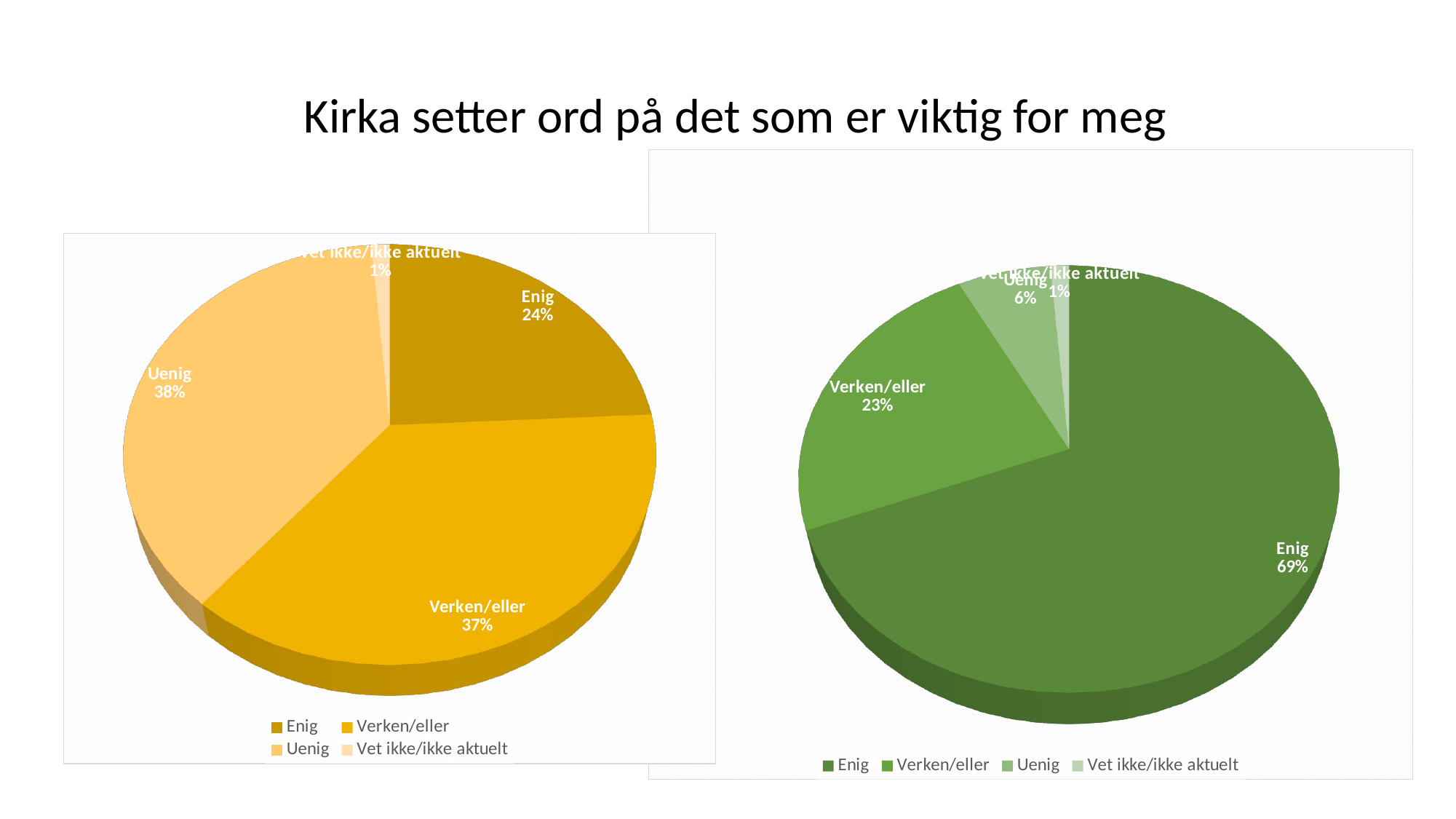
In the right pie chart, what is the share for Enig? 69% What kind of chart is the left chart? Pie chart In the right pie chart, what is the difference in percentage points between Enig and Verken/eller? 46 In the right pie chart, which category has the largest slice? Enig In the left pie chart, what is the share for Enig? 24% In the left pie chart, which category has the smallest slice? Vet ikke/ikke aktuelt In the left pie chart, what is the share for Verken/eller? 37% What colour scheme is used for the slices of the right pie chart? Green In the right pie chart, what is the share for Uenig? 6% In the left pie chart, which is larger: Enig or Verken/eller? Verken/eller What is the title of the slide above the two charts? Kirka setter ord på det som er viktig for meg How many categories does the right pie chart show? 4